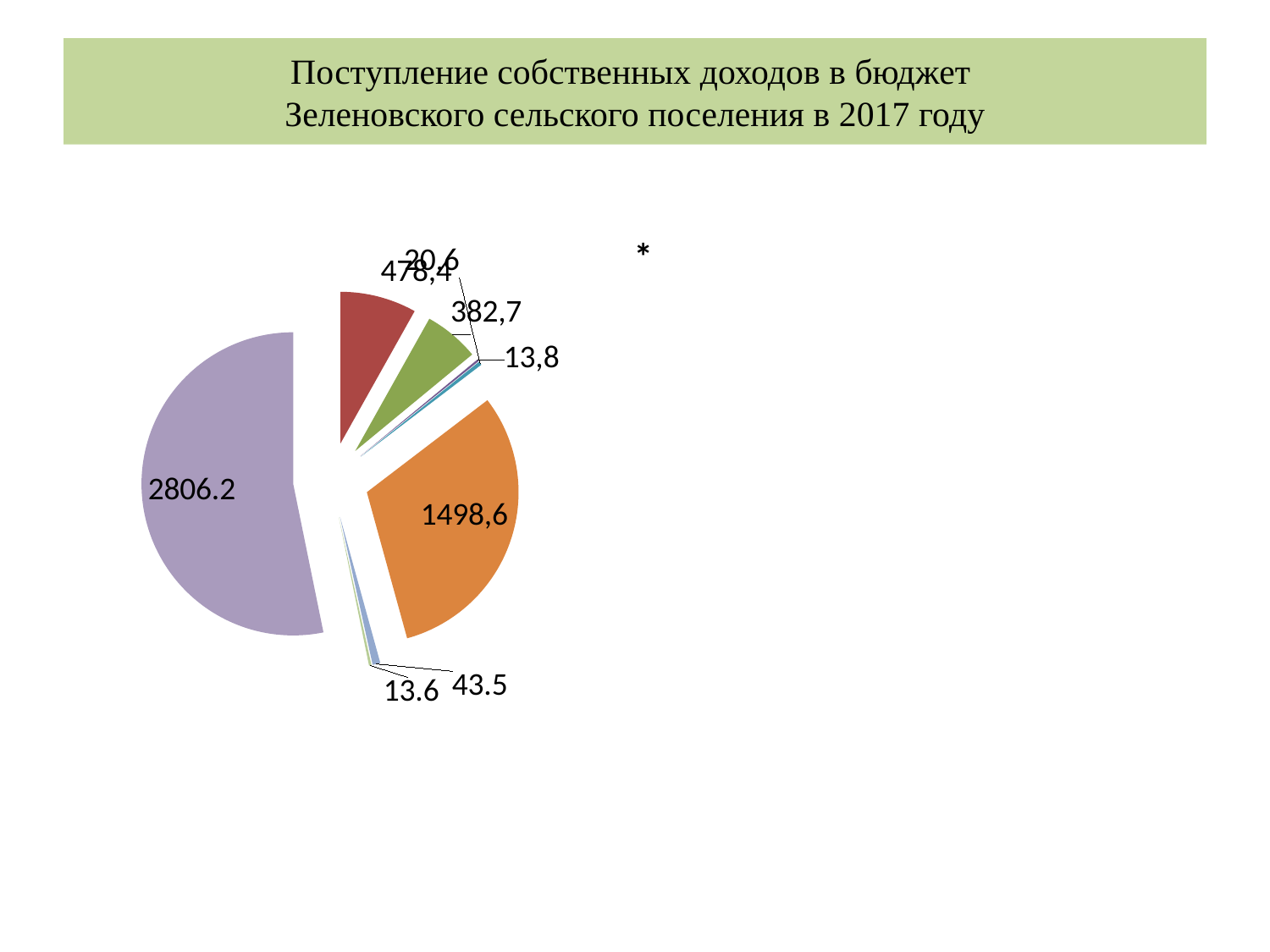
What is the difference between the dark red slice (478,4) and the green slice (382,7)? 95,7 What is the value of the largest slice of the pie chart? 2806.2 Does the pie chart include a legend? No Which slice is larger, the purple one or the orange one? the purple one How many slices does the pie chart have? 8 What value is labelled on the orange slice of the pie chart? 1498,6 What value is labelled on the purple slice of the pie chart? 2806.2 What value is labelled on the green slice of the pie chart? 382,7 What value is labelled on the dark red slice of the pie chart? 478,4 What kind of chart is shown on the slide? pie chart What is the title of the slide? Поступление собственных доходов в бюджет Зеленовского сельского поселения в 2017 году